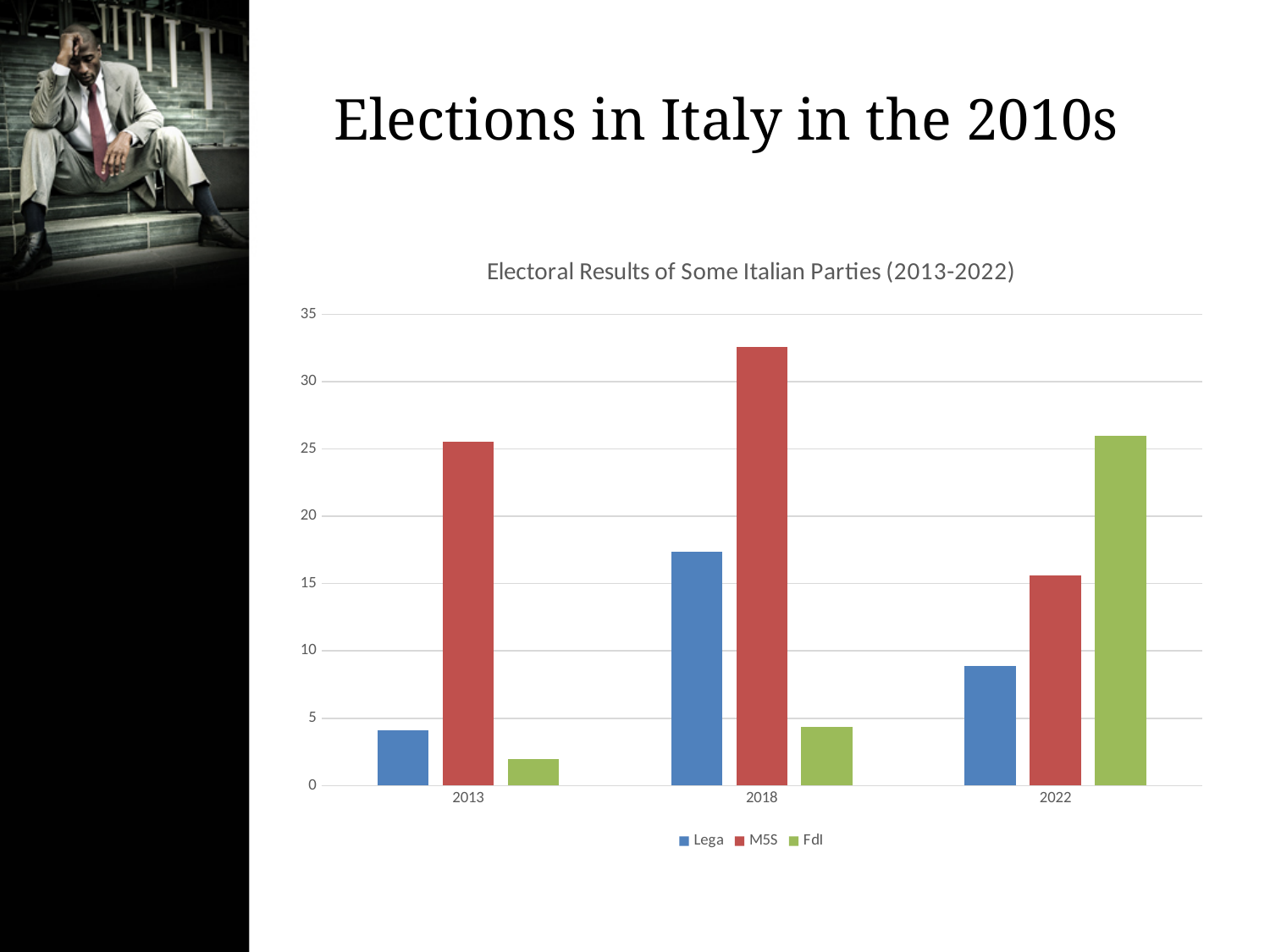
Is the value for FdI in 2022 greater or less than 25? greater What is the title of the chart? Electoral Results of Some Italian Parties (2013-2022) Is the value for Lega in 2013 greater or less than 5? less Is the value for M5S in 2018 greater or less than 30? greater Which party has the highest bar in 2022? FdI Which party has the lowest bar in 2013? FdI What type of chart is shown on the slide? bar chart How many series does the legend list? 3 Do the values for FdI rise or fall from 2013 to 2022? rise Which party has the highest bar in 2018? M5S Which is larger, the value for Lega in 2018 or the value for Lega in 2022? Lega in 2018 How many election years are shown on the x axis? 3